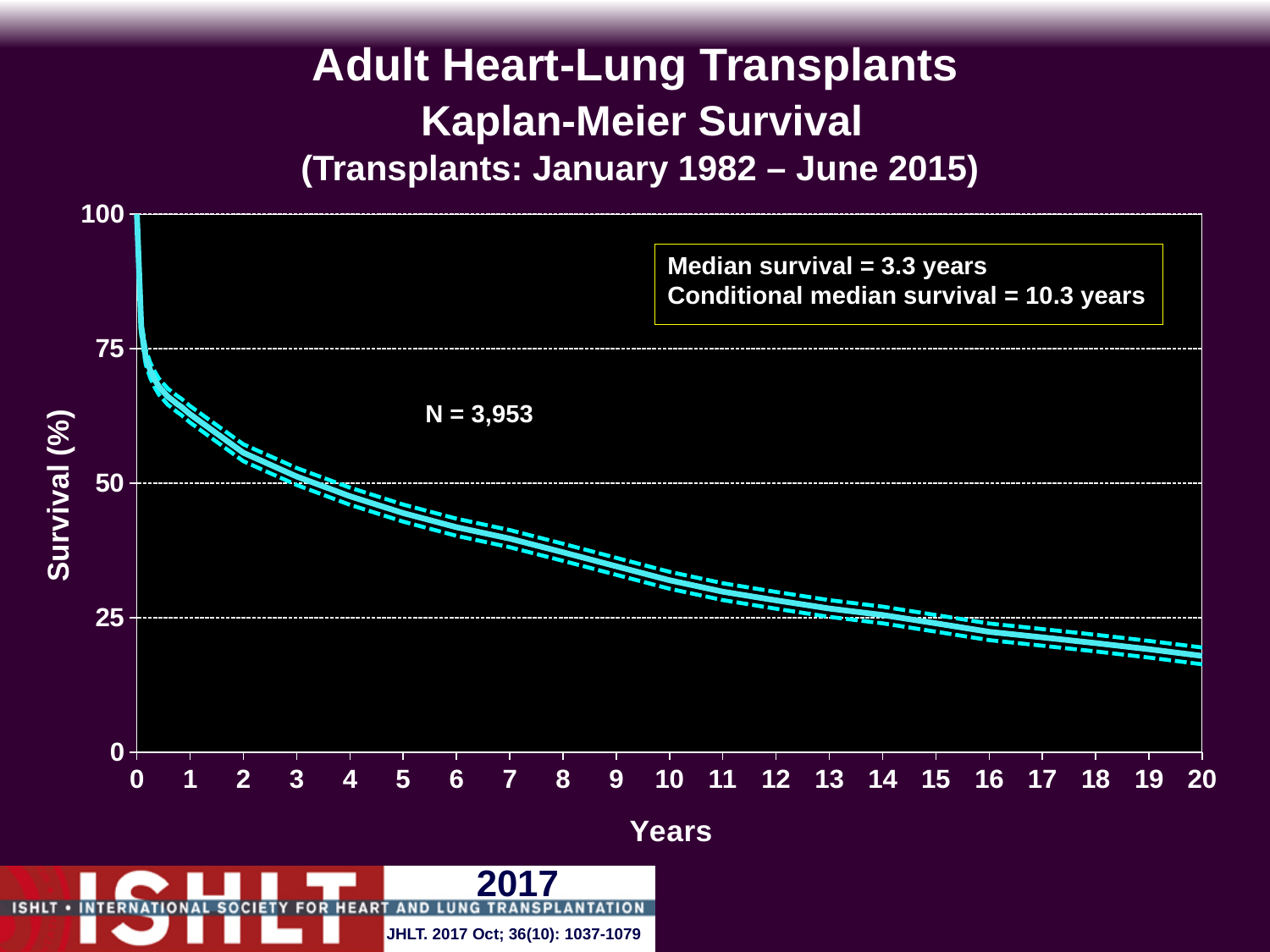
Is the survival value at 5 years greater or less than 50? less What is the value of N shown on the chart? 3,953 Is the survival value at 10 years greater or less than 25? greater What transplant date range is given in the chart title? January 1982 – June 2015 What is the conditional median survival stated on the chart? 10.3 years What kind of chart is shown on the slide? Line chart Is the survival value at 1 year greater or less than 75? less Do the survival values rise or fall as the years increase along the x axis? Fall What is the median survival stated on the chart? 3.3 years What is the label of the y axis? Survival (%)